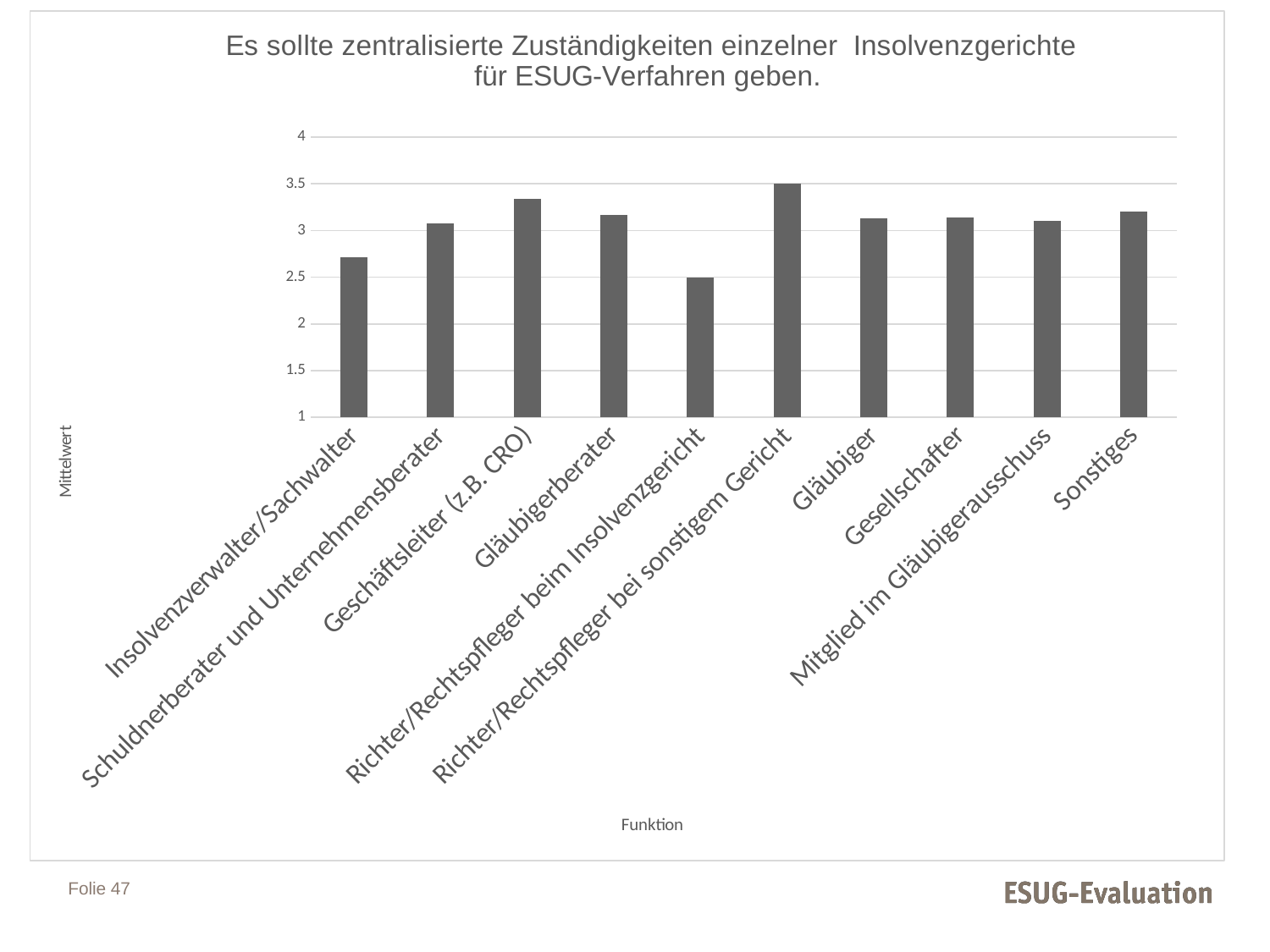
What kind of chart is shown on the slide? bar chart How many categories (Funktionen) are shown on the x axis? 10 Which category has the highest Mittelwert? Richter/Rechtspfleger bei sonstigem Gericht What is the label of the vertical axis? Mittelwert Is the value for Richter/Rechtspfleger bei sonstigem Gericht greater or less than 3? greater Which has the larger value: Insolvenzverwalter/Sachwalter or Richter/Rechtspfleger beim Insolvenzgericht? Insolvenzverwalter/Sachwalter Is the value for Insolvenzverwalter/Sachwalter greater or less than 3? less Is the value for Geschäftsleiter (z.B. CRO) greater or less than 3? greater What is the label of the horizontal axis? Funktion Which category has the lowest Mittelwert? Richter/Rechtspfleger beim Insolvenzgericht Which has the larger value: Geschäftsleiter (z.B. CRO) or Gläubigerberater? Geschäftsleiter (z.B. CRO)